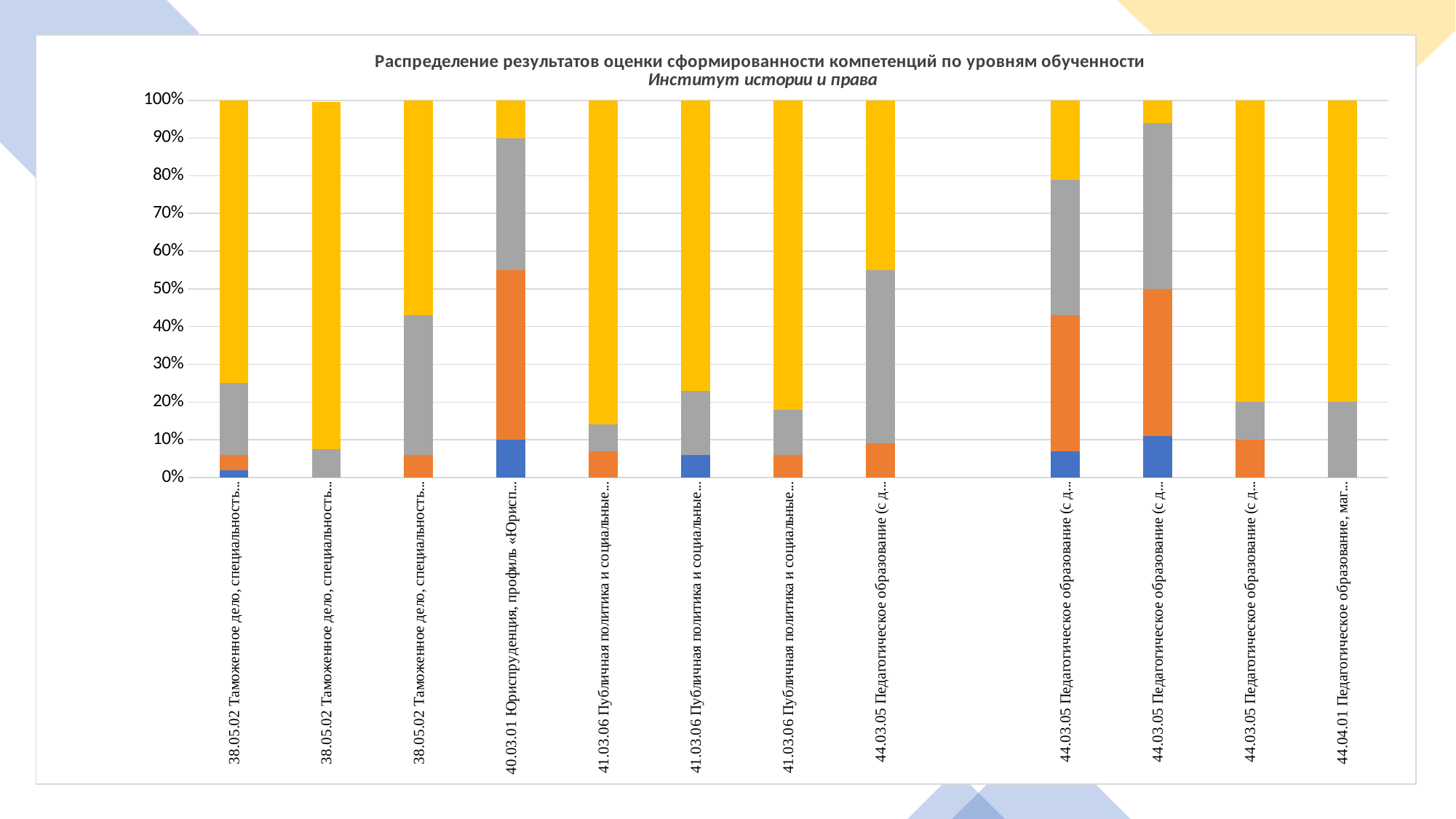
What is the title of the chart? Распределение результатов оценки сформированности компетенций по уровням обученности Which bar has the largest orange segment? 40.03.01 Юриспруденция How many stacked bars are plotted in the chart? 12 Is the yellow segment for 44.04.01 Педагогическое образование (the rightmost bar) greater or less than 70%? greater What is the total height of each stacked bar according to the axis? 100% Is the orange segment for 40.03.01 Юриспруденция greater or less than 40%? greater Is the blue segment for the tenth bar from the left (44.03.05 Педагогическое образование) greater or less than 20%? less What kind of chart is shown on the slide? Stacked bar chart Which has the larger yellow segment: 40.03.01 Юриспруденция or 44.04.01 Педагогическое образование (the rightmost bar)? 44.04.01 Педагогическое образование Which institute is named in the chart's subtitle? Институт истории и права